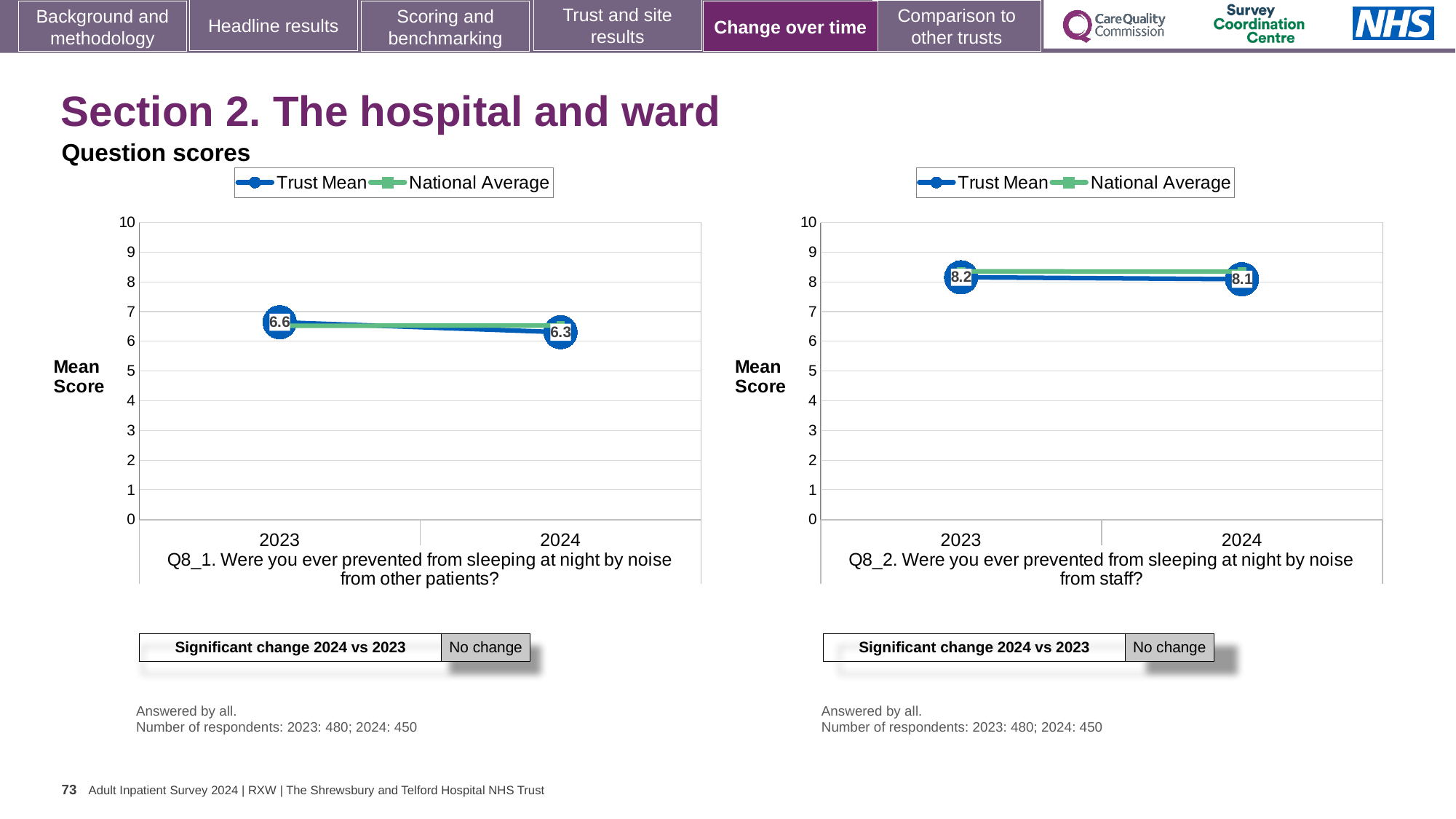
How many series does the legend of the right chart (Q8_2) list? 2 In the left chart (Q8_1), does the Trust Mean rise or fall from 2023 to 2024? fall What type of chart is used for Q8_1 on the left? line chart In the left chart (Q8_1), what is the Trust Mean score for 2023? 6.6 In the right chart (Q8_2), what is the Trust Mean score for 2024? 8.1 In the left chart (Q8_1), by how much did the Trust Mean change from 2023 to 2024? 0.3 In the left chart (Q8_1), what is the Trust Mean score for 2024? 6.3 How many years are plotted on the x axis of the left chart (Q8_1)? 2 In the left chart (Q8_1), is the National Average for 2024 greater or less than 7? less In the right chart (Q8_2), is the National Average for 2023 greater or less than 8? greater In the right chart (Q8_2), what is the difference between the Trust Mean for 2023 and 2024? 0.1 In the right chart (Q8_2), what is the Trust Mean score for 2023? 8.2